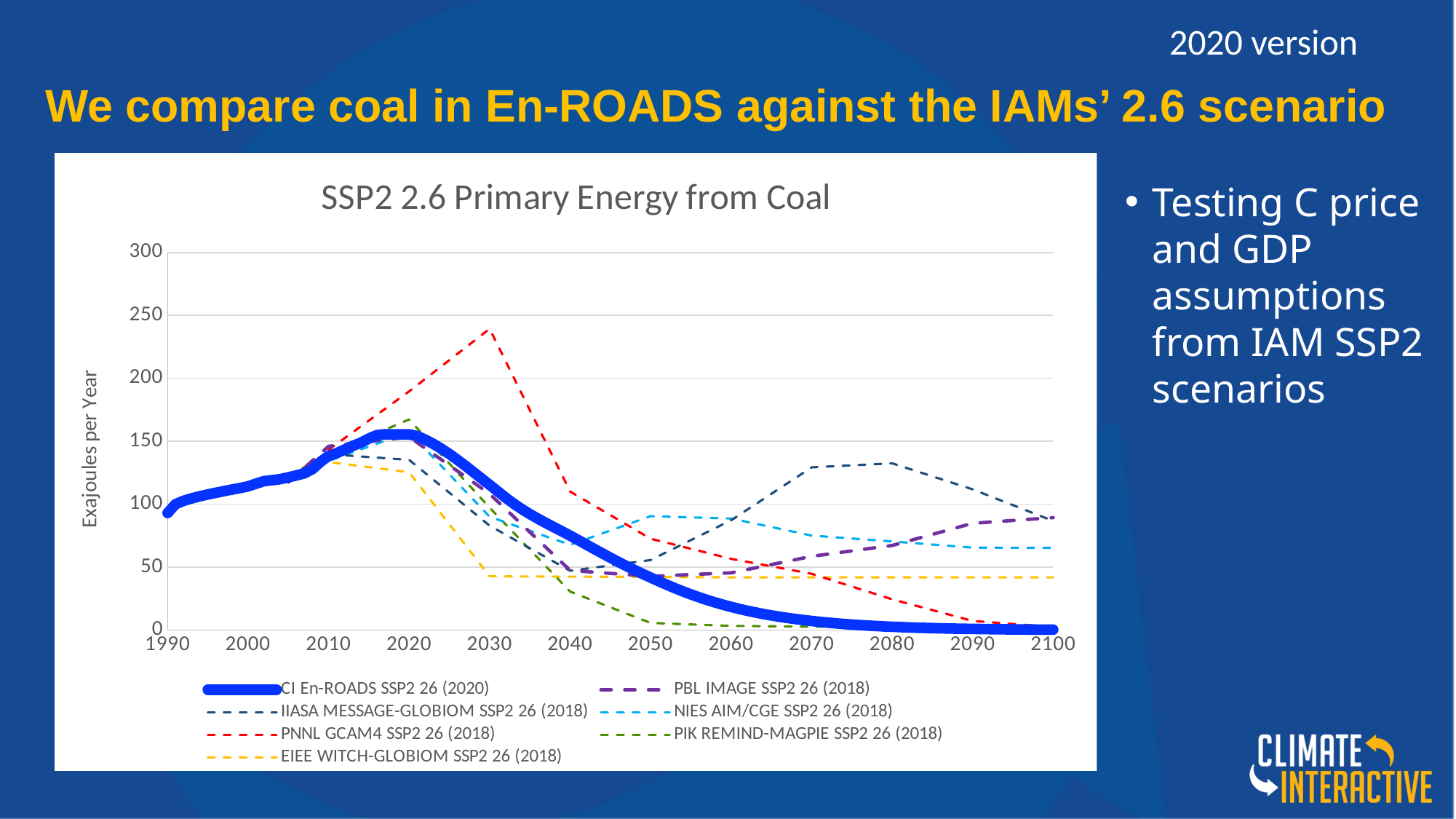
What is the label on the vertical axis? Exajoules per Year Is the value for CI En-ROADS SSP2 26 (2020) in 2060 greater or less than 50? less How many year labels are shown on the x axis? 12 Is the value for PNNL GCAM4 SSP2 26 (2018) in 2030 greater or less than 200? greater Does the CI En-ROADS SSP2 26 (2020) series rise or fall between 2020 and 2100? fall Which series reaches the highest value anywhere on the chart? PNNL GCAM4 SSP2 26 (2018) Is the value for IIASA MESSAGE-GLOBIOM SSP2 26 (2018) in 2080 greater or less than 100? greater How many series does the legend list? 7 Which is larger in 2080: IIASA MESSAGE-GLOBIOM SSP2 26 (2018) or PBL IMAGE SSP2 26 (2018)? IIASA MESSAGE-GLOBIOM SSP2 26 (2018) What is the title of the chart? SSP2 2.6 Primary Energy from Coal What kind of chart is shown on the slide? line chart